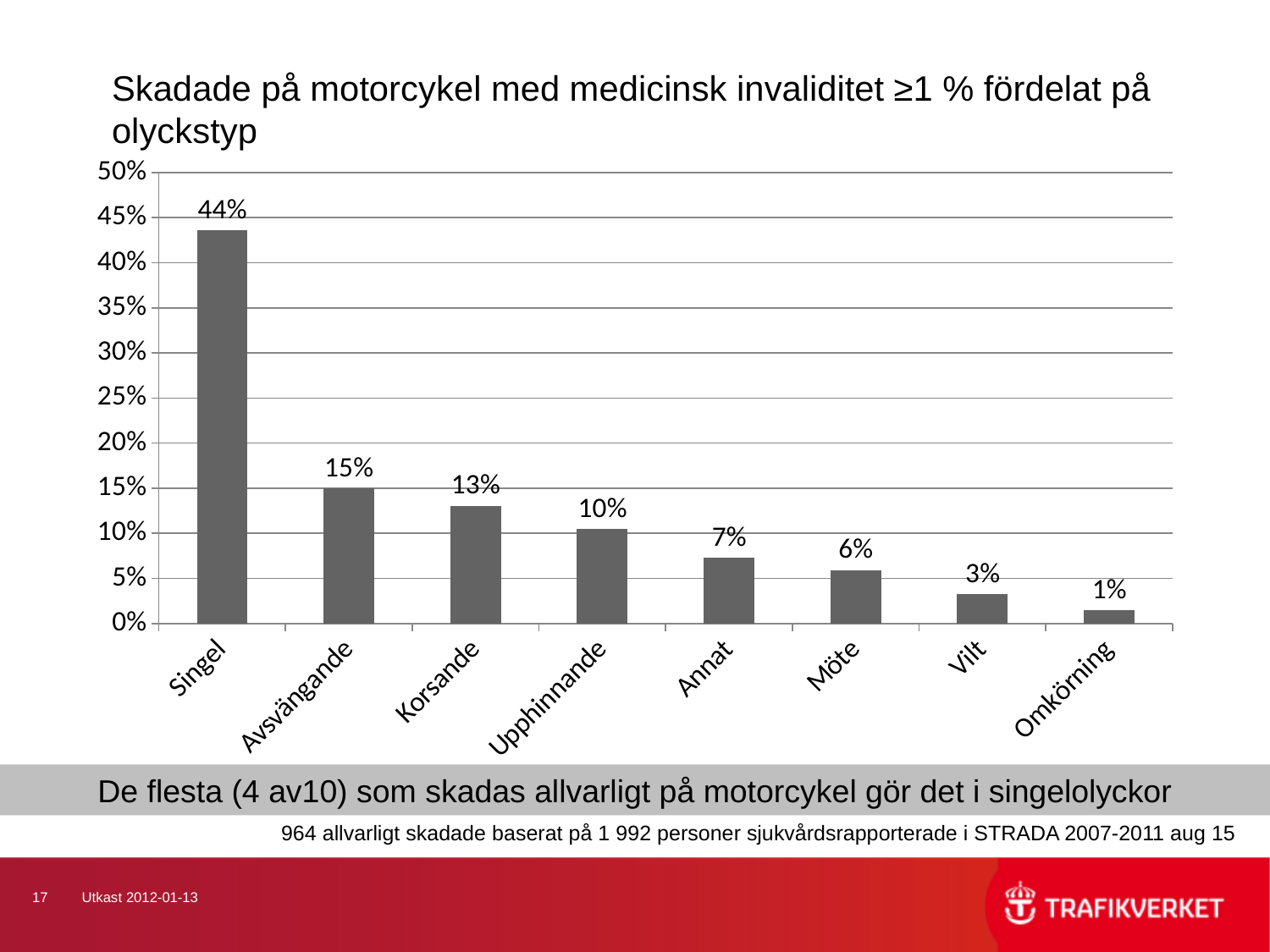
What is the value for Upphinnande? 10% What is the value for Avsvängande? 15% What is the value for Vilt? 3% Which accident type has the highest share? Singel What kind of chart is shown on the slide? Bar chart What is the value for Singel? 44% Which is larger, the value for Annat or the value for Möte? Annat Do the values rise or fall from left to right along the x axis? Fall How many accident types are shown on the x axis? 8 What is the difference between the values for Singel and Avsvängande? 29% Which accident type has the lowest share? Omkörning What is the difference between the values for Korsande and Möte? 7%